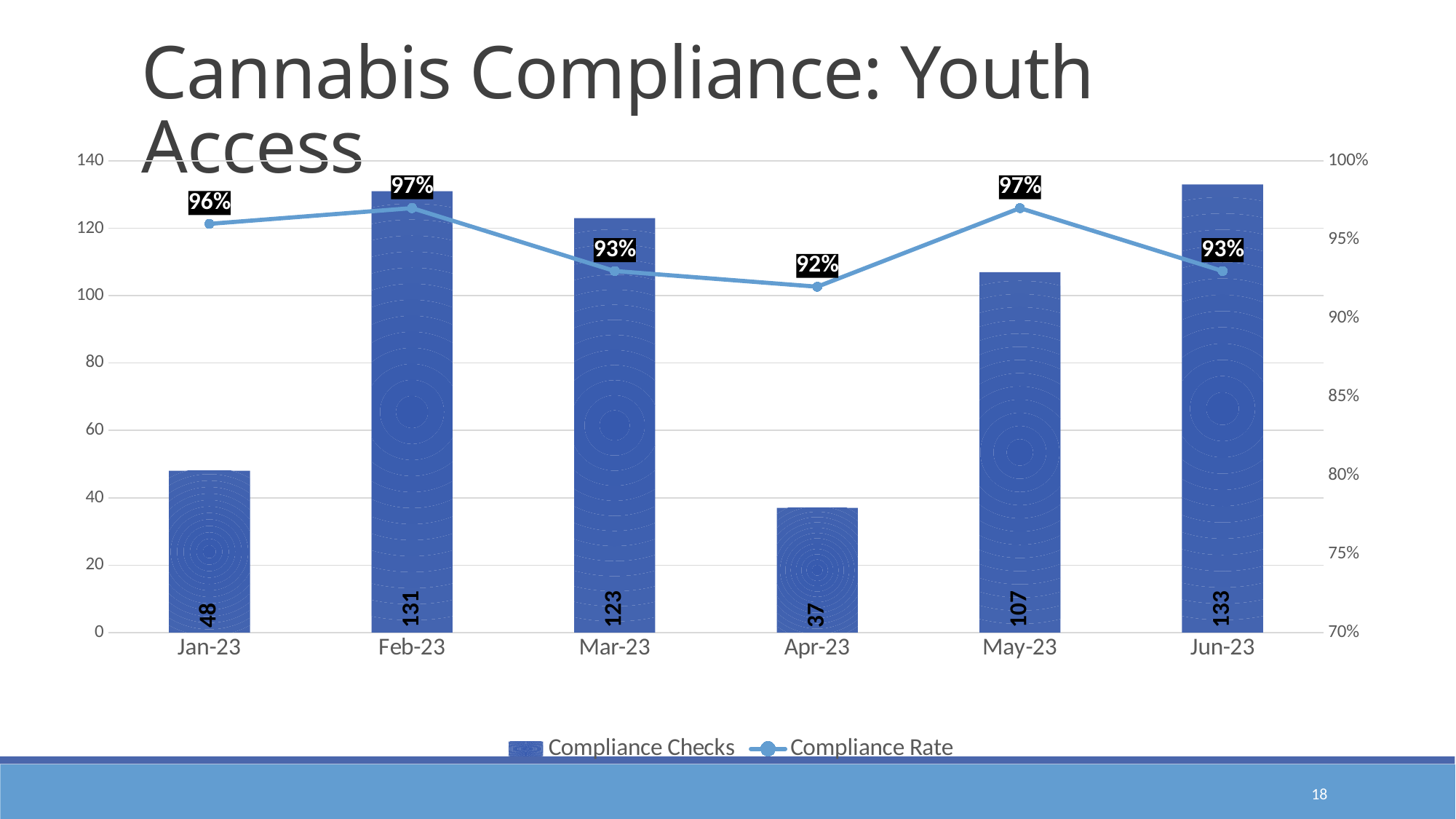
Which month had more Compliance Checks, Mar-23 or May-23? Mar-23 How many series does the legend list? 2 What kind of chart is used to show Compliance Checks? Bar chart Which month had the lowest Compliance Rate? Apr-23 Which month had the lowest number of Compliance Checks? Apr-23 Which month had the highest number of Compliance Checks? Jun-23 What is the title of the slide? Cannabis Compliance: Youth Access How many Compliance Checks were conducted in Feb-23? 131 What is the difference in Compliance Checks between Jun-23 and Jan-23? 85 How many months are shown on the x axis? 6 How many Compliance Checks were conducted in Apr-23? 37 What was the Compliance Rate in Apr-23? 92%